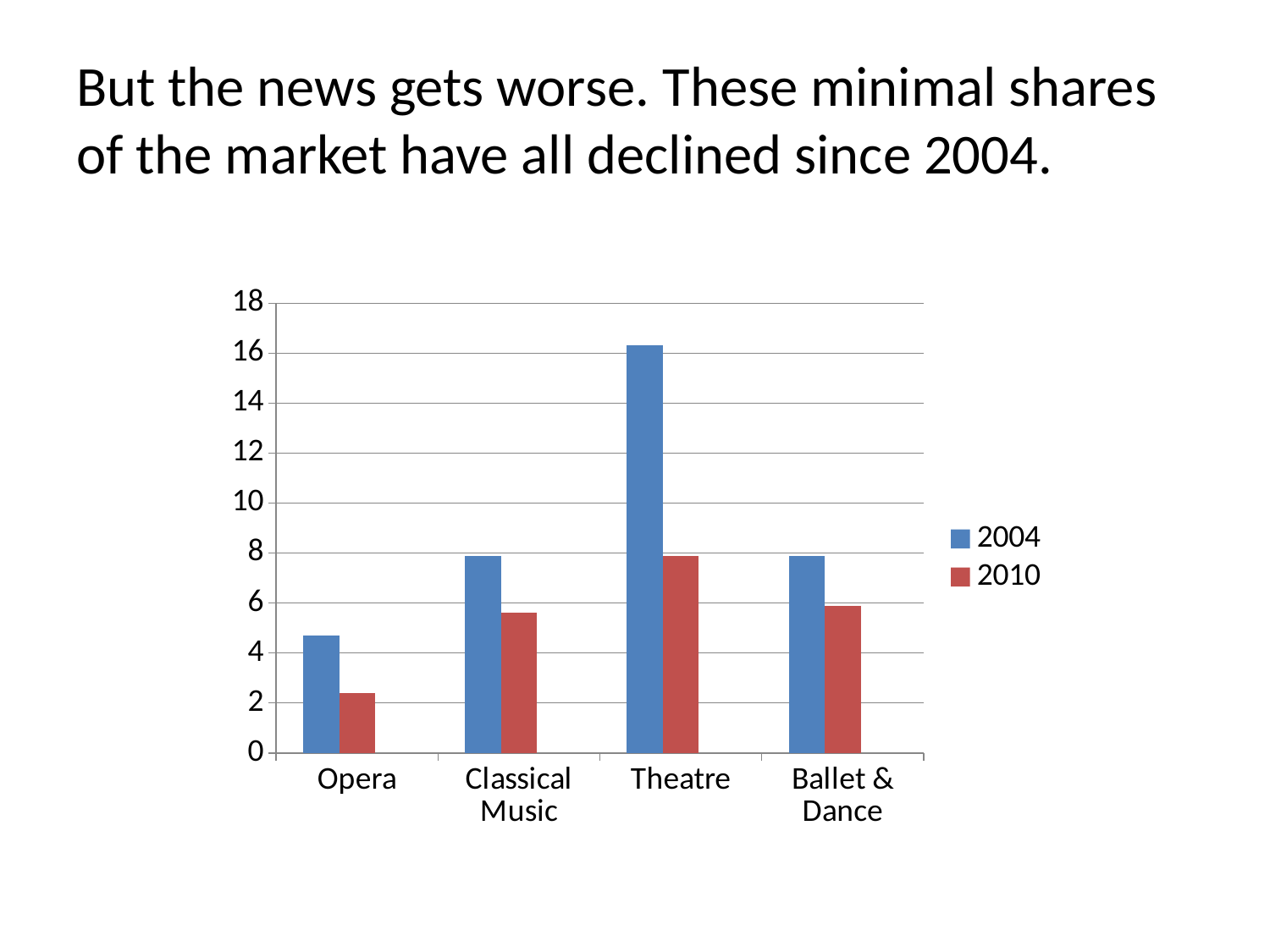
Which category has the highest value for 2010? Theatre How many series does the chart's legend list? 2 Is the 2004 value for Opera greater or less than 4? greater Which category has the lowest value for 2004? Opera Is the 2010 value for Opera greater or less than 4? less How many categories are shown on the x axis of the chart? 4 Which series is shown in blue in the chart's legend? 2004 Is the 2004 value for Theatre greater or less than 14? greater Which category has the lowest value for 2010? Opera Which category has the highest value for 2004? Theatre What kind of chart is shown on the slide? bar chart Which is larger for Theatre: the 2004 value or the 2010 value? 2004